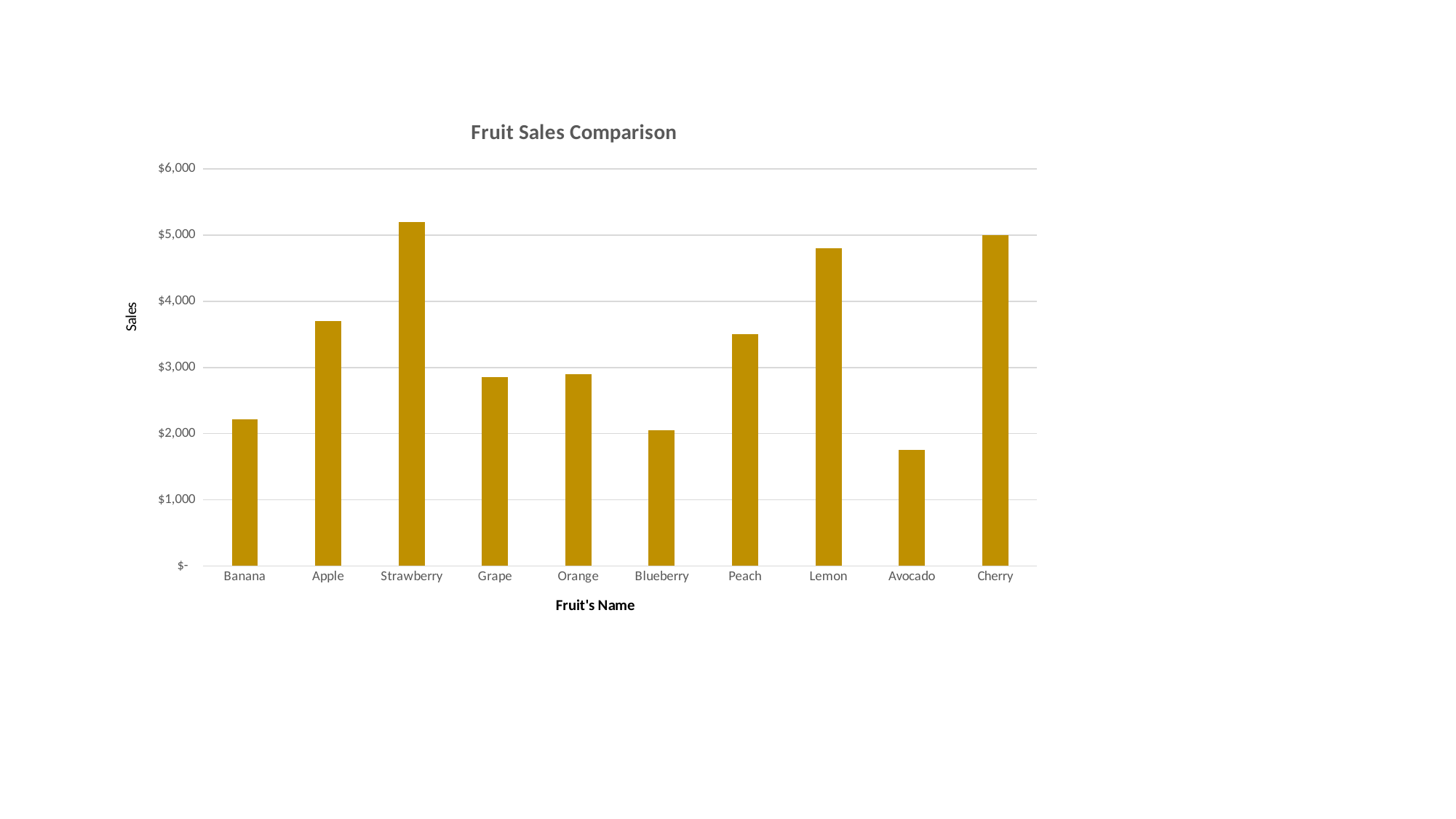
Is the value for Banana greater or less than $2,000? greater What kind of chart is shown on the slide? Bar chart Is the value for Grape greater or less than $3,000? less Is the value for Apple greater or less than $4,000? less What is the title of the chart? Fruit Sales Comparison Which fruit has the highest sales? Strawberry Which fruit has the lowest sales? Avocado How many fruits are shown on the x axis of the chart? 10 Which has higher sales, Apple or Peach? Apple What is the label of the x axis? Fruit's Name